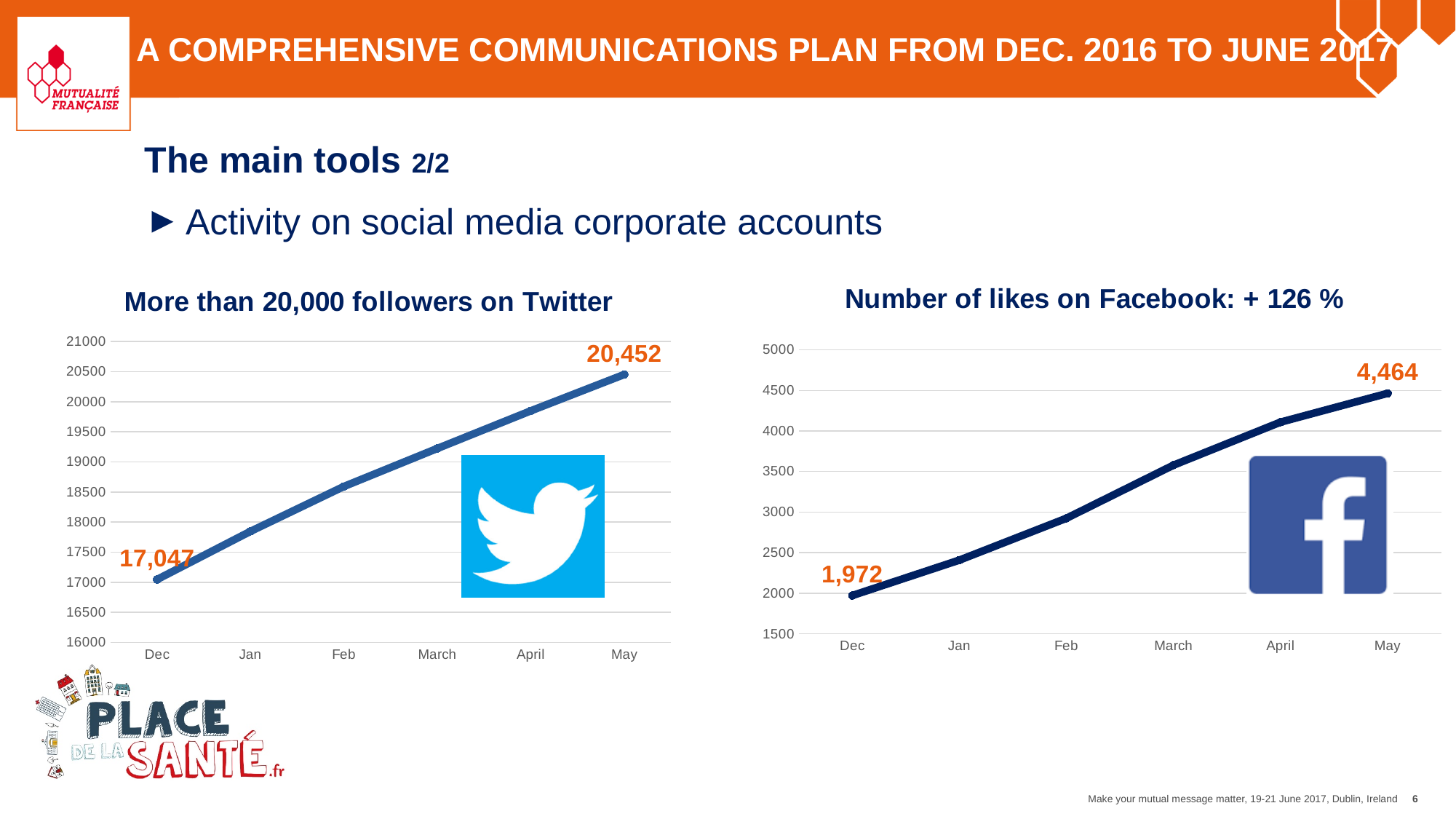
In the Twitter followers chart, which month has the highest value? May In the Twitter followers chart, what is the difference between the May and Dec values? 3,405 In the Facebook likes chart, is the value for Jan greater or less than 2000? greater In the Facebook likes chart, what is the value for May? 4,464 In the Facebook likes chart, what is the value for Dec? 1,972 In the Twitter followers chart, what is the value for Dec? 17,047 How many months are plotted on the x axis of the Facebook likes chart? 6 What kind of chart is the Twitter followers chart? line chart In the Facebook likes chart, which month has the lowest value? Dec In the Twitter followers chart, what is the value for May? 20,452 In the Facebook likes chart, what is the difference between the May and Dec values? 2,492 In the Twitter followers chart, is the value for Feb greater or less than 18000? greater